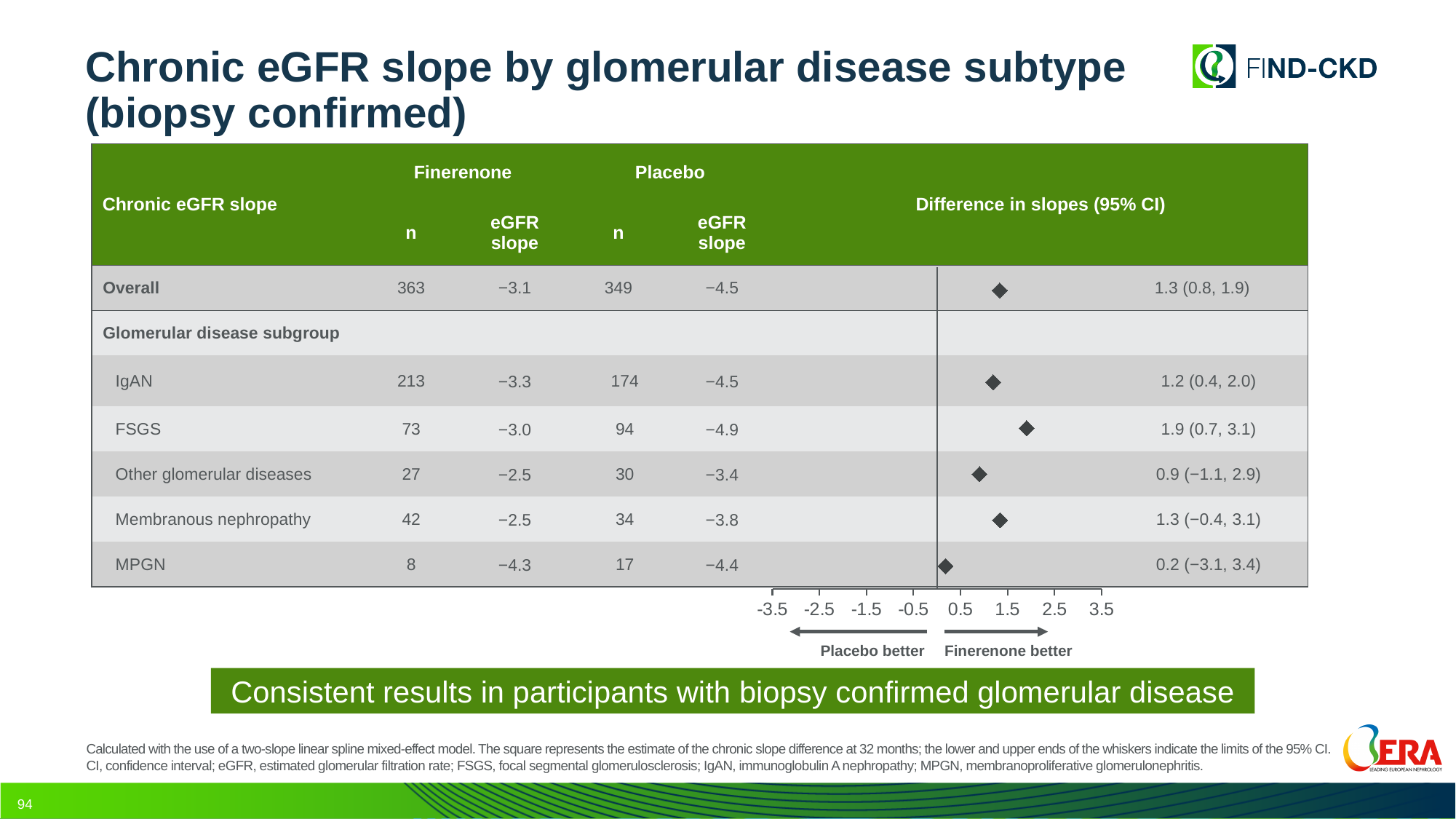
What is the difference in slopes (95% CI) for FSGS? 1.9 (0.7, 3.1) What is the difference in slopes (95% CI) for MPGN? 0.2 (−3.1, 3.4) What kind of chart is shown on the slide? Forest plot What is the difference between the point estimates for FSGS and MPGN? 1.7 Which glomerular disease subgroup has the smallest point estimate for the difference in slopes? MPGN Which has the larger point estimate for the difference in slopes, FSGS or IgAN? FSGS Which side of the forest plot axis is labelled 'Finerenone better'? The right side Is the point estimate for FSGS greater or less than 1.5? greater What is the finerenone eGFR slope for IgAN? −3.3 How many rows have a point estimate plotted in the forest plot? 6 What is the difference in slopes (95% CI) for the Overall group? 1.3 (0.8, 1.9) Which glomerular disease subgroup has the largest point estimate for the difference in slopes? FSGS